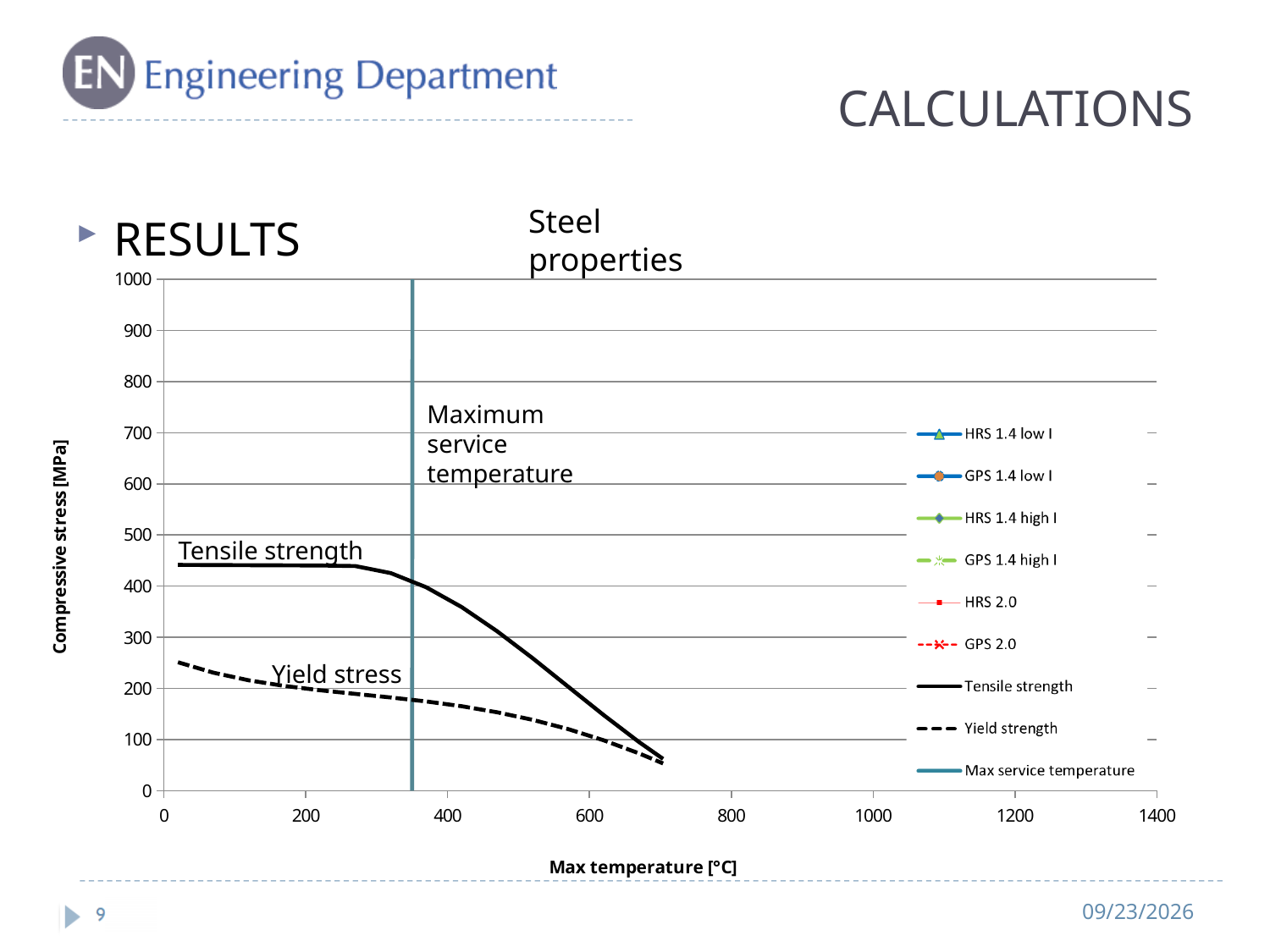
Is the Max service temperature line positioned at a temperature greater or less than 400 °C? less Is the Yield strength value at 400 °C greater or less than 200 MPa? less How many series does the chart legend list? 9 What is the label of the x axis? Max temperature [°C] What kind of chart is shown on the slide? line chart At 400 °C, which is larger: Tensile strength or Yield strength? Tensile strength Is the Tensile strength value at 400 °C greater or less than 400 MPa? less Does the Tensile strength curve rise or fall as the max temperature increases? fall What is the label of the y axis? Compressive stress [MPa] Does the Yield strength curve rise or fall as the max temperature increases? fall